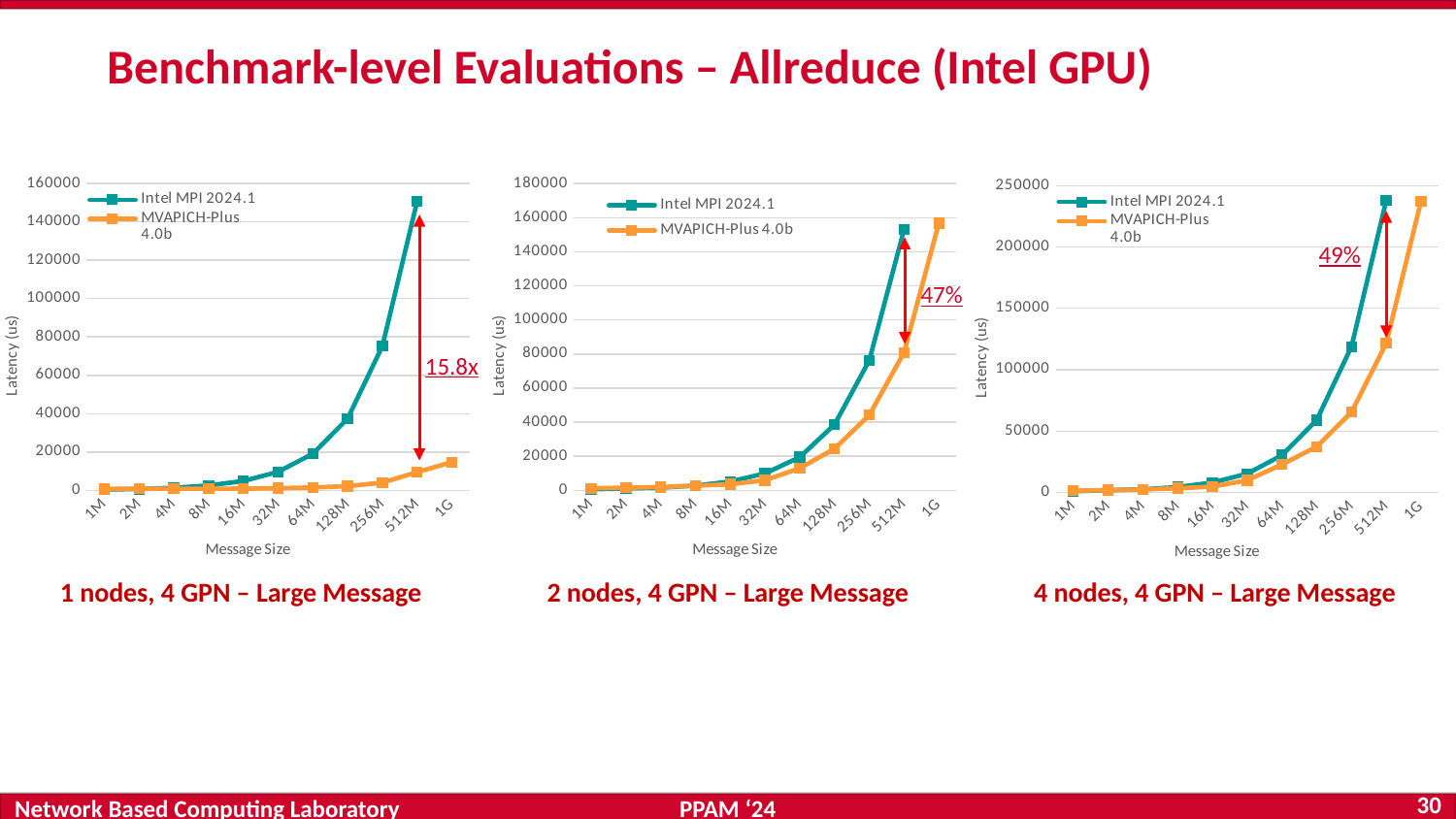
In the '2 nodes, 4 GPN – Large Message' chart, is the MVAPICH-Plus 4.0b latency at 512M greater or less than 100000? less In the '1 nodes, 4 GPN – Large Message' chart, is the Intel MPI 2024.1 latency at 512M greater or less than 140000? greater In the '1 nodes, 4 GPN – Large Message' chart, does the Intel MPI 2024.1 latency rise or fall as message size increases from 1M to 512M? rise In the '4 nodes, 4 GPN – Large Message' chart, which series has the higher latency at 512M, Intel MPI 2024.1 or MVAPICH-Plus 4.0b? Intel MPI 2024.1 What percentage is annotated on the '4 nodes, 4 GPN – Large Message' chart? 49% In the '4 nodes, 4 GPN – Large Message' chart, is the Intel MPI 2024.1 latency at 512M greater or less than 200000? greater What kind of chart is the '1 nodes, 4 GPN – Large Message' chart? line chart How many message sizes are shown on the x axis of the '4 nodes, 4 GPN – Large Message' chart? 11 What improvement factor is annotated on the '1 nodes, 4 GPN – Large Message' chart? 15.8x In the '2 nodes, 4 GPN – Large Message' chart, which series has the lower latency at 256M? MVAPICH-Plus 4.0b How many series does the legend list in the '2 nodes, 4 GPN – Large Message' chart? 2